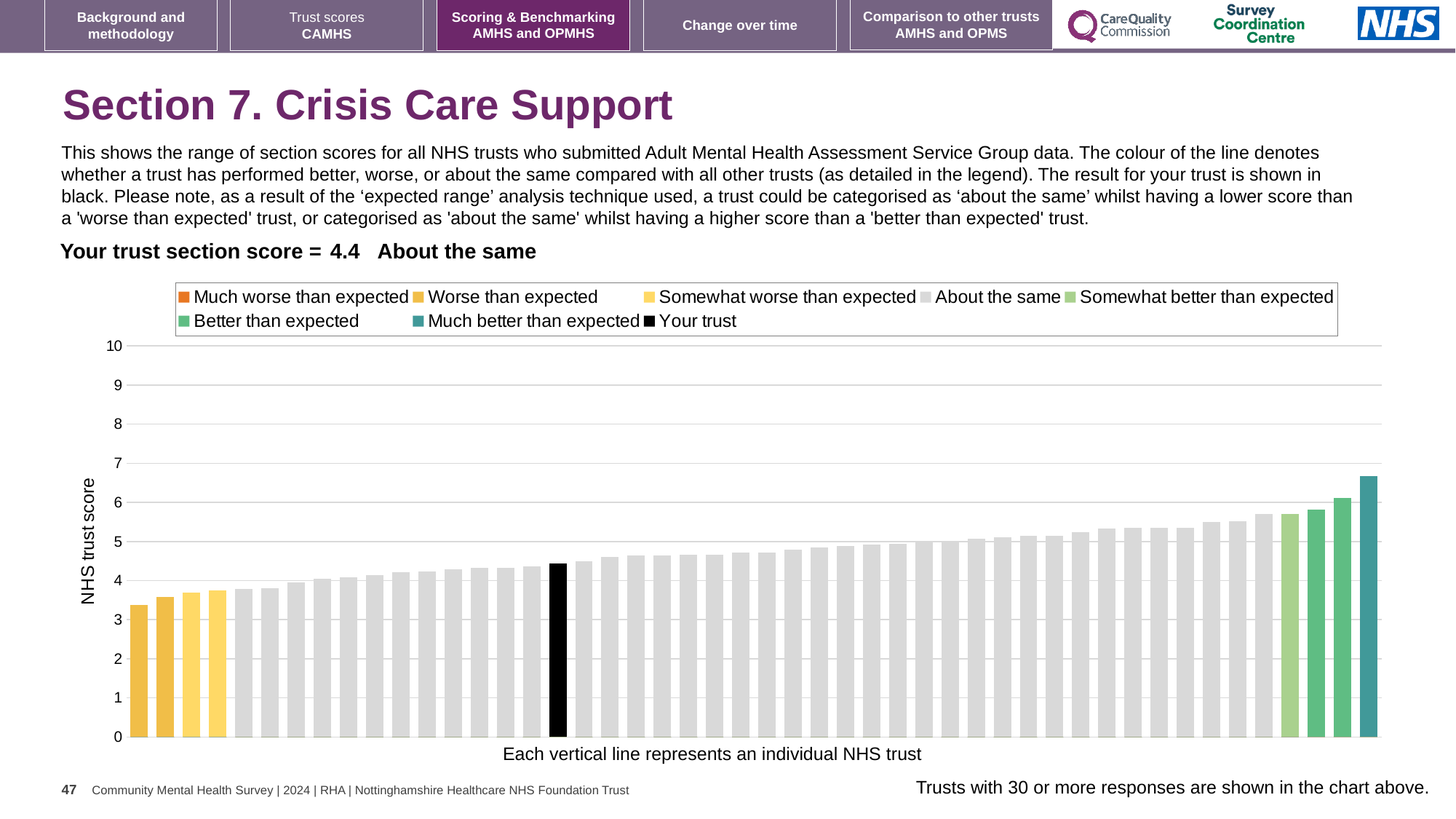
How many bars are coloured as 'Much better than expected'? 1 Is the value of the tallest bar in the chart greater or less than 6? greater What is the section score for your trust, as printed on the slide? 4.4 Do the bar values rise or fall from left to right along the x axis? rise What kind of chart is shown on the slide? bar chart Which is higher, the black bar for your trust or the teal 'Much better than expected' bar? the teal 'Much better than expected' bar Is the value for your trust (the black bar) greater or less than 4? greater What is the label on the vertical axis of the chart? NHS trust score Is the value of the shortest bar in the chart greater or less than 4? less What colour is the bar representing your trust? black Which category is your trust placed in for this section? About the same How many entries does the chart legend list? 8